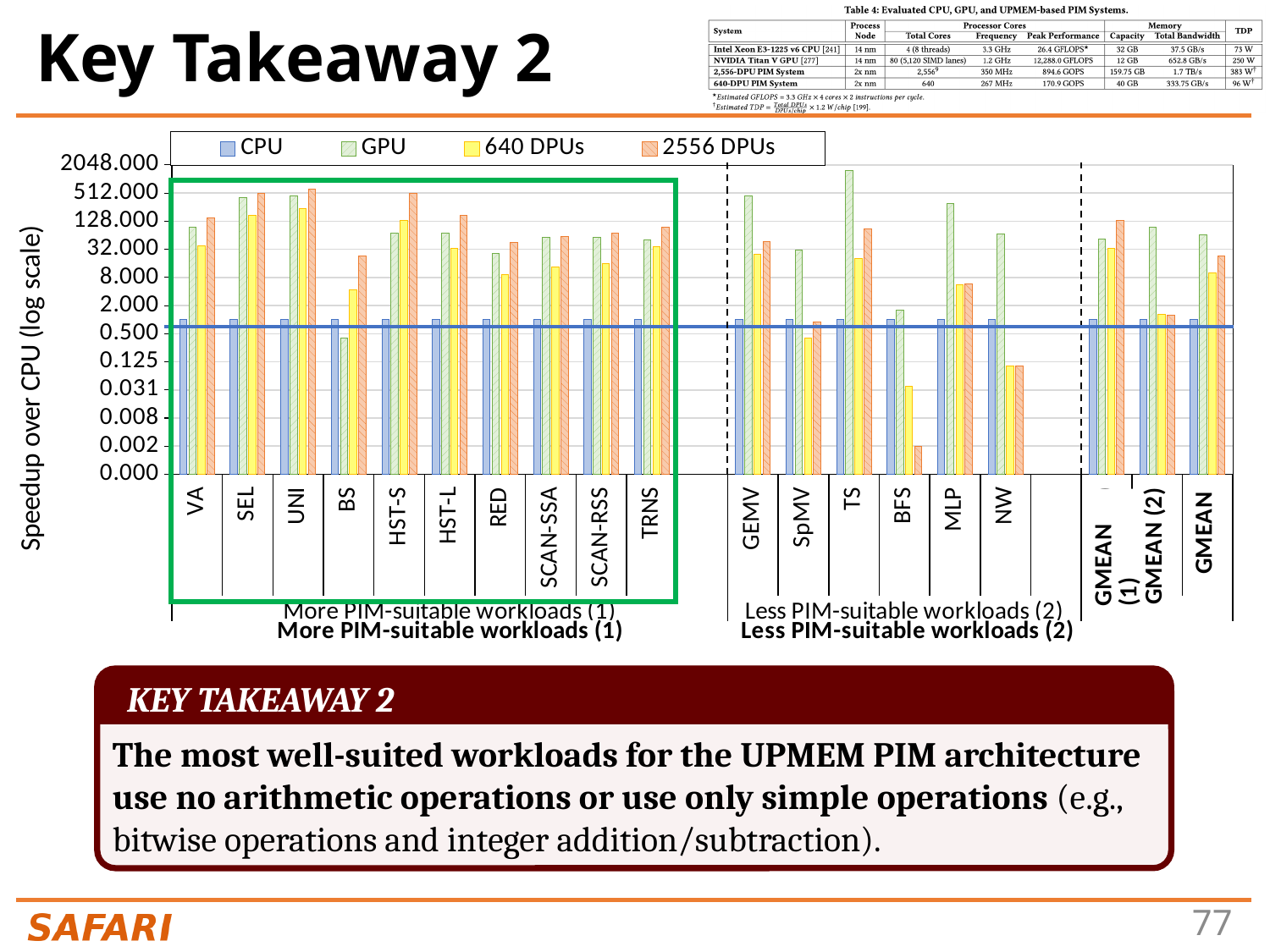
How many workload categories are shown along the x axis of the chart? 19 Is the 2556 DPUs value for UNI greater or less than 128.000? greater For TS, which is larger: the GPU value or the 2556 DPUs value? GPU Is the 2556 DPUs value for BFS greater or less than 0.008? less How many series does the chart legend list? 4 What kind of chart is shown on the slide? bar chart Is the 640 DPUs value for NW greater or less than 0.500? less For BFS, which is larger: the 640 DPUs value or the 2556 DPUs value? 640 DPUs Which series in the legend is shown in blue? CPU What is the label of the y axis of the chart? Speedup over CPU (log scale) Which workload has the highest GPU speedup in the chart? TS